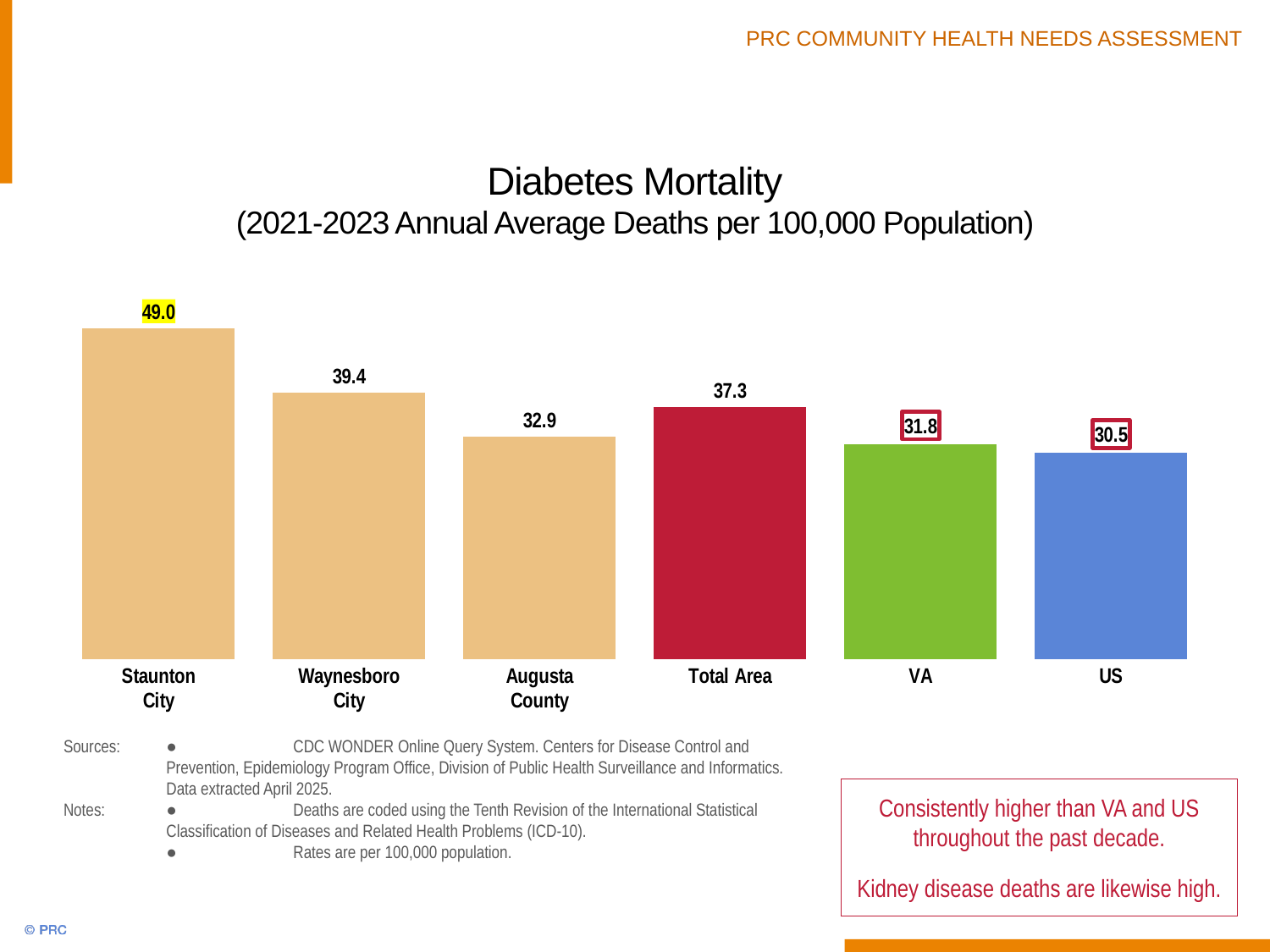
What is the diabetes mortality rate for the US? 30.5 Which category has the highest diabetes mortality rate? Staunton City What is the diabetes mortality rate for the Total Area? 37.3 What kind of chart is shown on the slide? Bar chart Which category has the lowest diabetes mortality rate? US How many categories are shown in the chart? 6 What is the difference between the diabetes mortality rates for the Total Area and VA? 5.5 What is the diabetes mortality rate for Augusta County? 32.9 What is the diabetes mortality rate for Staunton City? 49.0 What is the difference between the diabetes mortality rates for Staunton City and the US? 18.5 Which has a higher diabetes mortality rate, Waynesboro City or Augusta County? Waynesboro City What is the diabetes mortality rate for Waynesboro City? 39.4